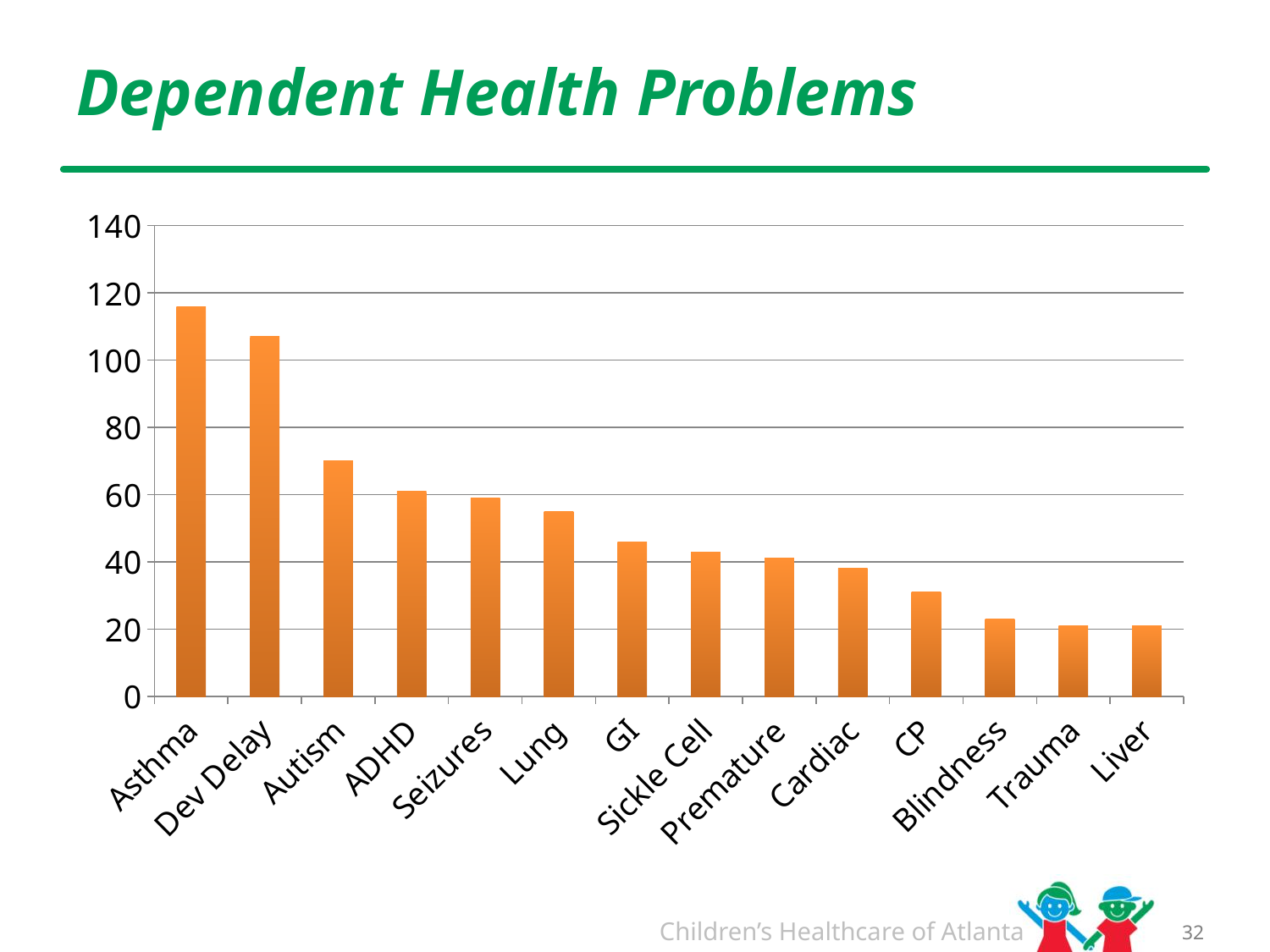
What kind of chart is shown on the slide? bar chart Which is larger, the value for Lung or the value for GI? Lung Is the value for Lung greater or less than 60? less Is the value for CP greater or less than 40? less Is the value for Asthma greater or less than 100? greater How many health problem categories are plotted on the chart? 14 Which health problem has the highest value on the chart? Asthma Do the values rise or fall moving from left to right along the x axis? fall What is the title of the slide containing the chart? Dependent Health Problems Which is larger, the value for Asthma or the value for Dev Delay? Asthma